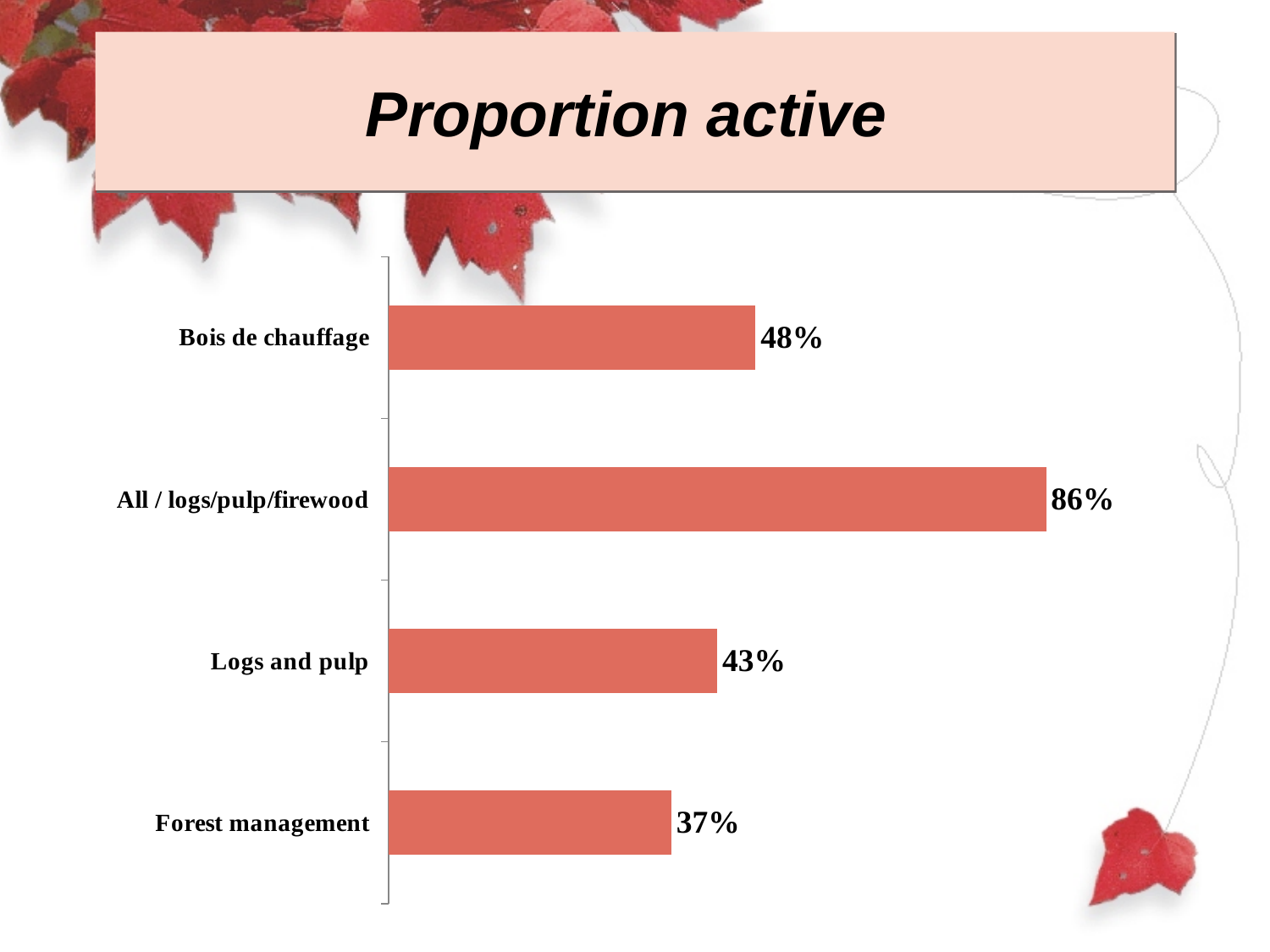
What is the title of the slide containing the chart? Proportion active How many categories are shown in the chart? 4 Which category has the highest value? All / logs/pulp/firewood What is the value for All / logs/pulp/firewood? 86% What is the difference between the values for All / logs/pulp/firewood and Forest management? 49% What is the difference between the values for Bois de chauffage and Logs and pulp? 5% What is the value for Bois de chauffage? 48% Which is larger, the value for Bois de chauffage or the value for Logs and pulp? Bois de chauffage What kind of chart is shown on the slide? Bar chart What is the value for Logs and pulp? 43% What is the value for Forest management? 37% Which category has the lowest value? Forest management